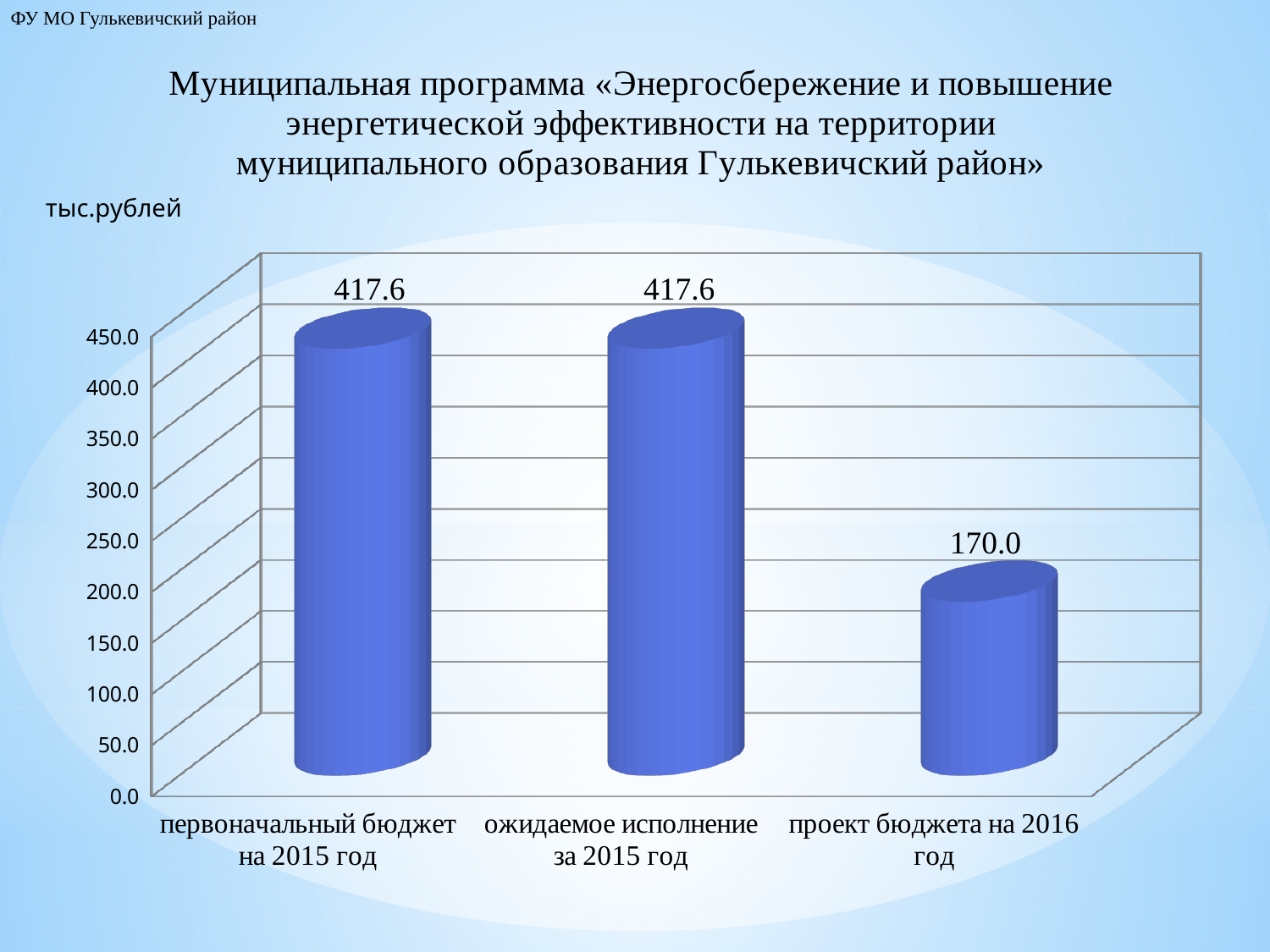
Is the value for «проект бюджета на 2016 год» greater or less than 200.0? less Which category has the lowest value? проект бюджета на 2016 год What is the value for «ожидаемое исполнение за 2015 год»? 417.6 How many categories are shown on the chart? 3 What is the value for «первоначальный бюджет на 2015 год»? 417.6 Is the value for «ожидаемое исполнение за 2015 год» greater or less than 400.0? greater What is the value for «проект бюджета на 2016 год»? 170.0 Which is larger: «первоначальный бюджет на 2015 год» or «проект бюджета на 2016 год»? первоначальный бюджет на 2015 год Do the values rise or fall from the first category to the last? fall What kind of chart is shown on the slide? bar chart What is the difference between «ожидаемое исполнение за 2015 год» and «проект бюджета на 2016 год»? 247.6 What unit is indicated above the chart? тыс.рублей